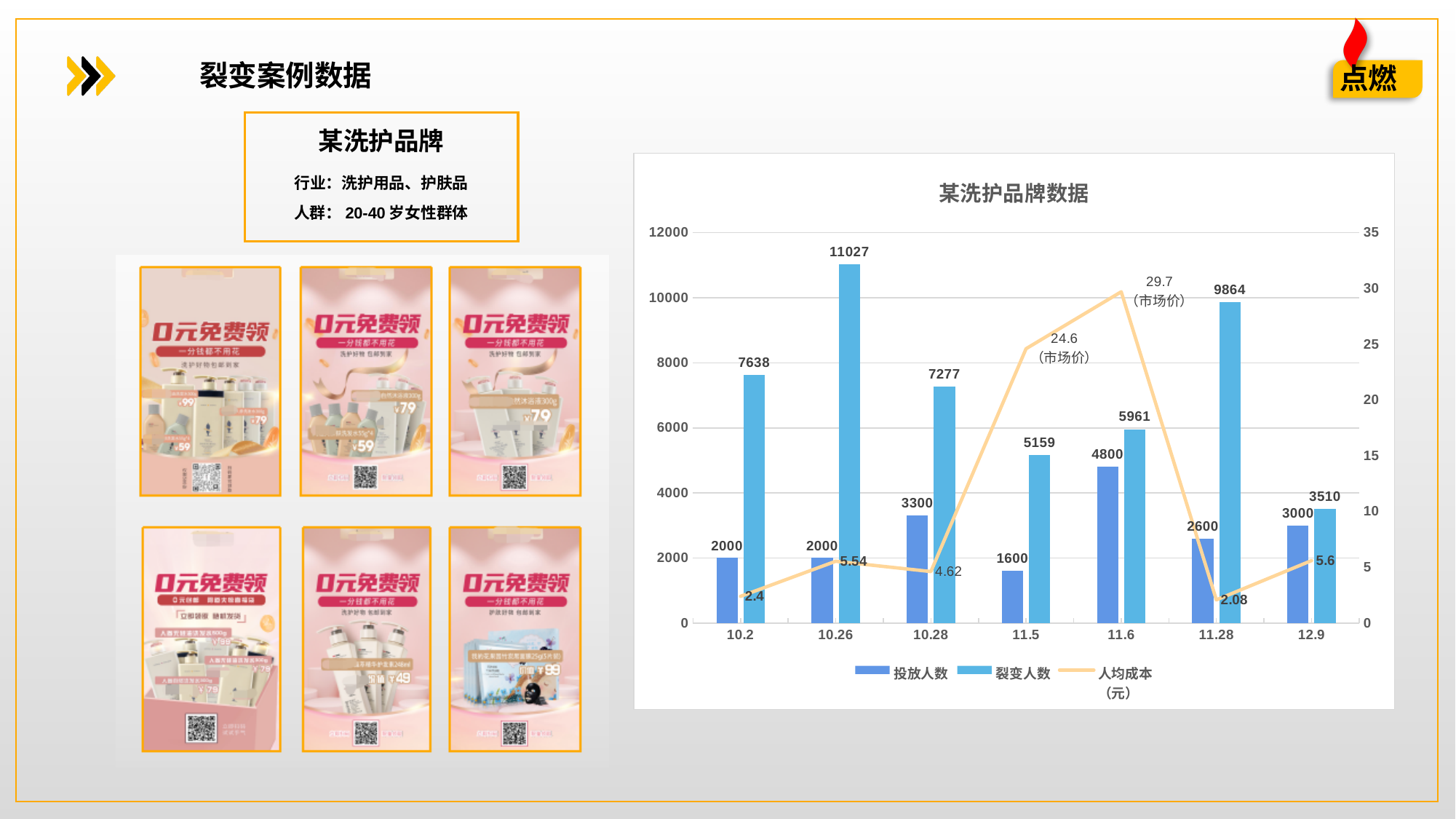
Which date has the lowest 投放人数? 11.5 What is the title of the chart? 某洗护品牌数据 What is the 投放人数 value for 11.6? 4800 Which date has the highest 裂变人数? 10.26 What is the 裂变人数 value for 10.26? 11027 How many series does the legend list? 3 What kind of chart is this? Combined bar and line chart What is the difference between 裂变人数 and 投放人数 on 11.28? 7264 Does 裂变人数 rise or fall from 11.28 to 12.9? Fall Which is larger on 12.9, 投放人数 or 裂变人数? 裂变人数 What is the 人均成本（元） value for 11.28? 2.08 How many dates are shown on the x axis? 7